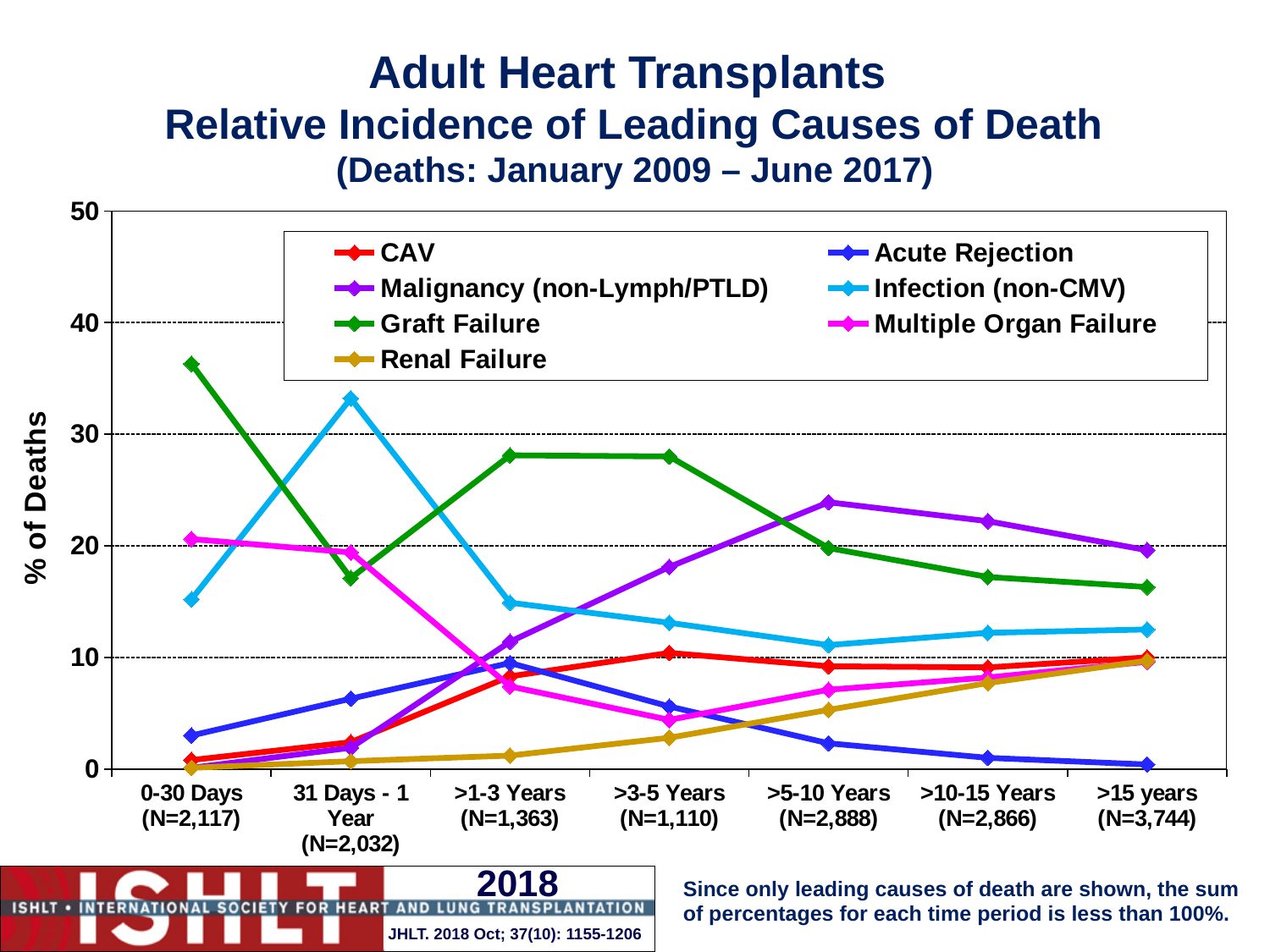
Which cause of death has the highest percentage in the 0-30 Days period? Graft Failure What type of chart is shown on the slide? Line chart Is the value for Multiple Organ Failure in the >3-5 Years period greater or less than 10? less Which cause of death has the highest percentage in the 31 Days - 1 Year period? Infection (non-CMV) What is the label on the y axis? % of Deaths Is the value for Graft Failure in the 0-30 Days period greater or less than 30? greater Which cause of death has the highest percentage in the >5-10 Years period? Malignancy (non-Lymph/PTLD) How many time periods are shown along the x axis? 7 In the >3-5 Years period, which is larger: Graft Failure or Malignancy (non-Lymph/PTLD)? Graft Failure How many causes of death does the legend list? 7 Which cause of death has the lowest percentage in the >15 years period? Acute Rejection Does the Renal Failure line rise or fall across the time periods from 0-30 Days to >15 years? Rises